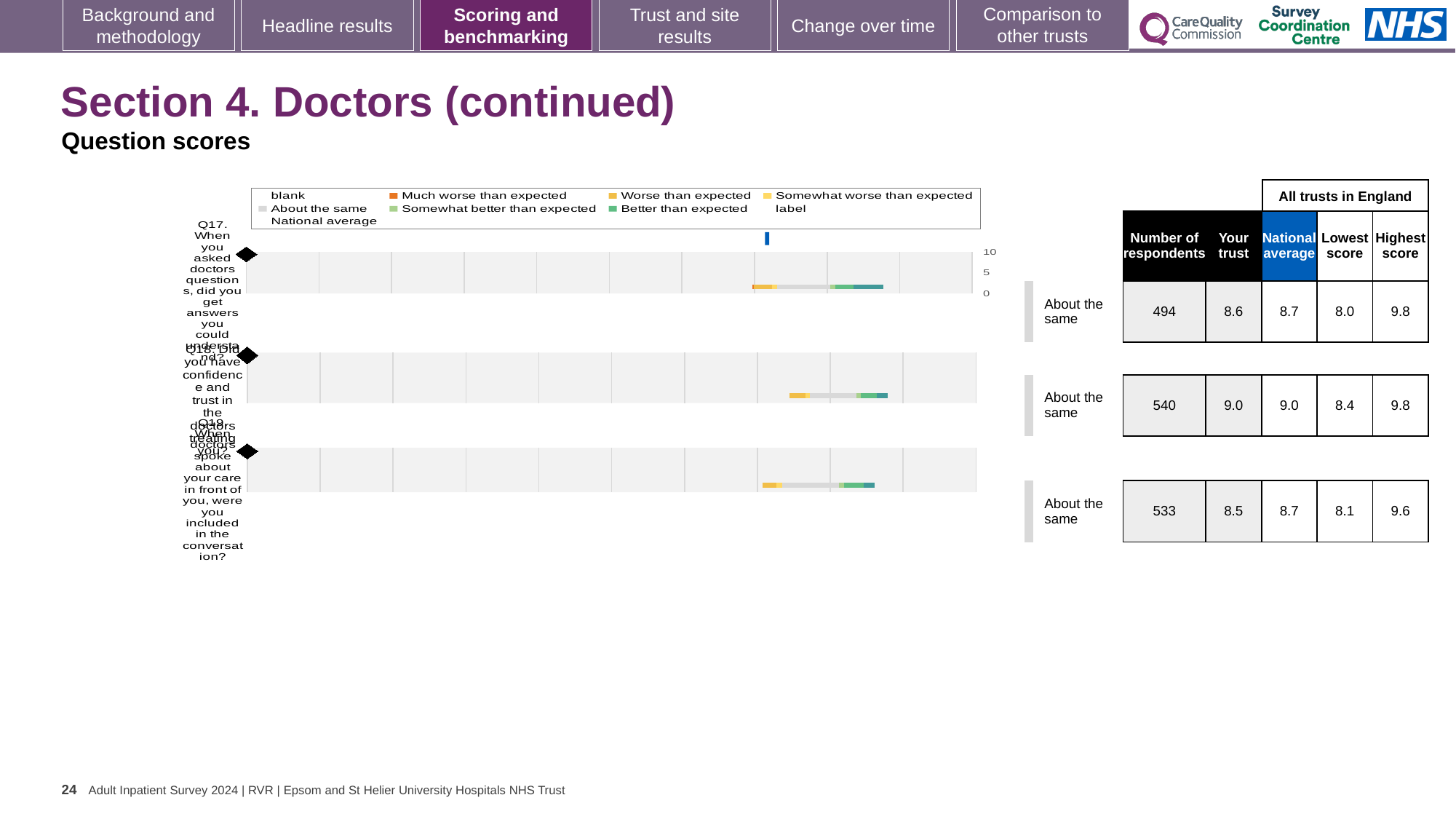
Which is larger: the 'Your trust' score for Q17 or for Q19? Q17 What is the 'Your trust' score for Q17 (When you asked doctors questions, did you get answers you could understand)? 8.6 What benchmark category is shown for all three questions on this slide? About the same Which question has the highest 'Your trust' score? Q18 For Q19, how much higher is the national average than the 'Your trust' score? 0.2 What kind of chart is used to show the question scores on this slide? bar chart How many respondents are listed for Q18 (Did you have confidence and trust in the doctors treating you)? 540 How many questions (rows) are plotted in the question scores chart? 3 What is the highest score across all trusts in England for Q19? 9.6 What is the national average score for Q19 (When doctors spoke about your care in front of you, were you included in the conversation)? 8.7 For Q17, what is the difference between the highest score and the lowest score across all trusts in England? 1.8 Which question has the lowest number of respondents? Q17